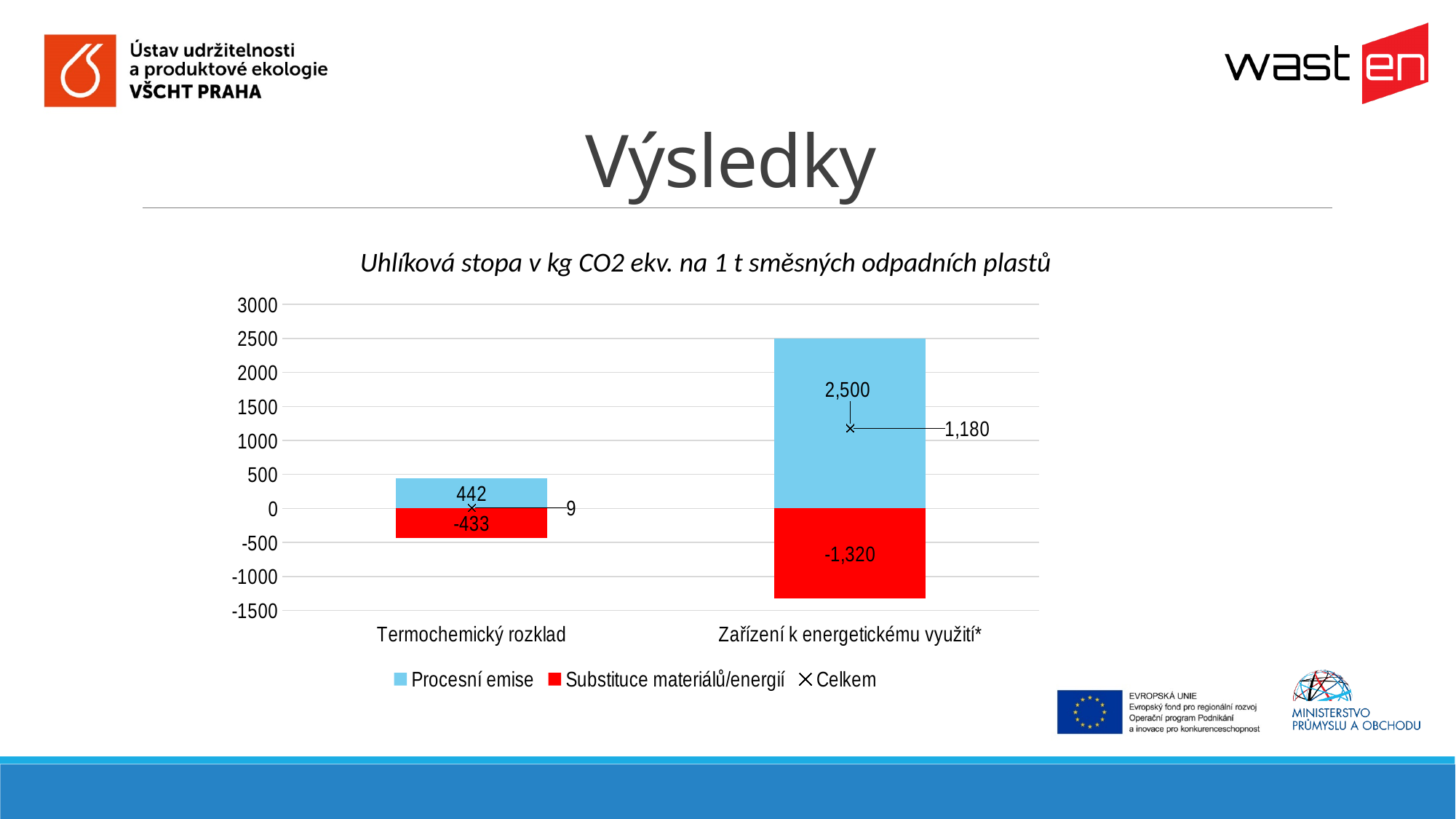
What is the difference between the Procesní emise values for Zařízení k energetickému využití* and Termochemický rozklad? 2,058 What is the Celkem value for Zařízení k energetickému využití*? 1,180 What is the Celkem value for Termochemický rozklad? 9 Which category has the higher Procesní emise value? Zařízení k energetickému využití* How many series does the legend list? 3 What kind of chart is shown on the slide? stacked bar chart What is the title of the chart? Uhlíková stopa v kg CO2 ekv. na 1 t směsných odpadních plastů How many categories are shown on the x axis? 2 Is the Celkem value for Termochemický rozklad larger or smaller than the Celkem value for Zařízení k energetickému využití*? smaller Is the Procesní emise value for Zařízení k energetickému využití* greater or less than 2000? greater What is the value of Substituce materiálů/energií for Zařízení k energetickému využití*? -1,320 What is the value of Procesní emise for Termochemický rozklad? 442